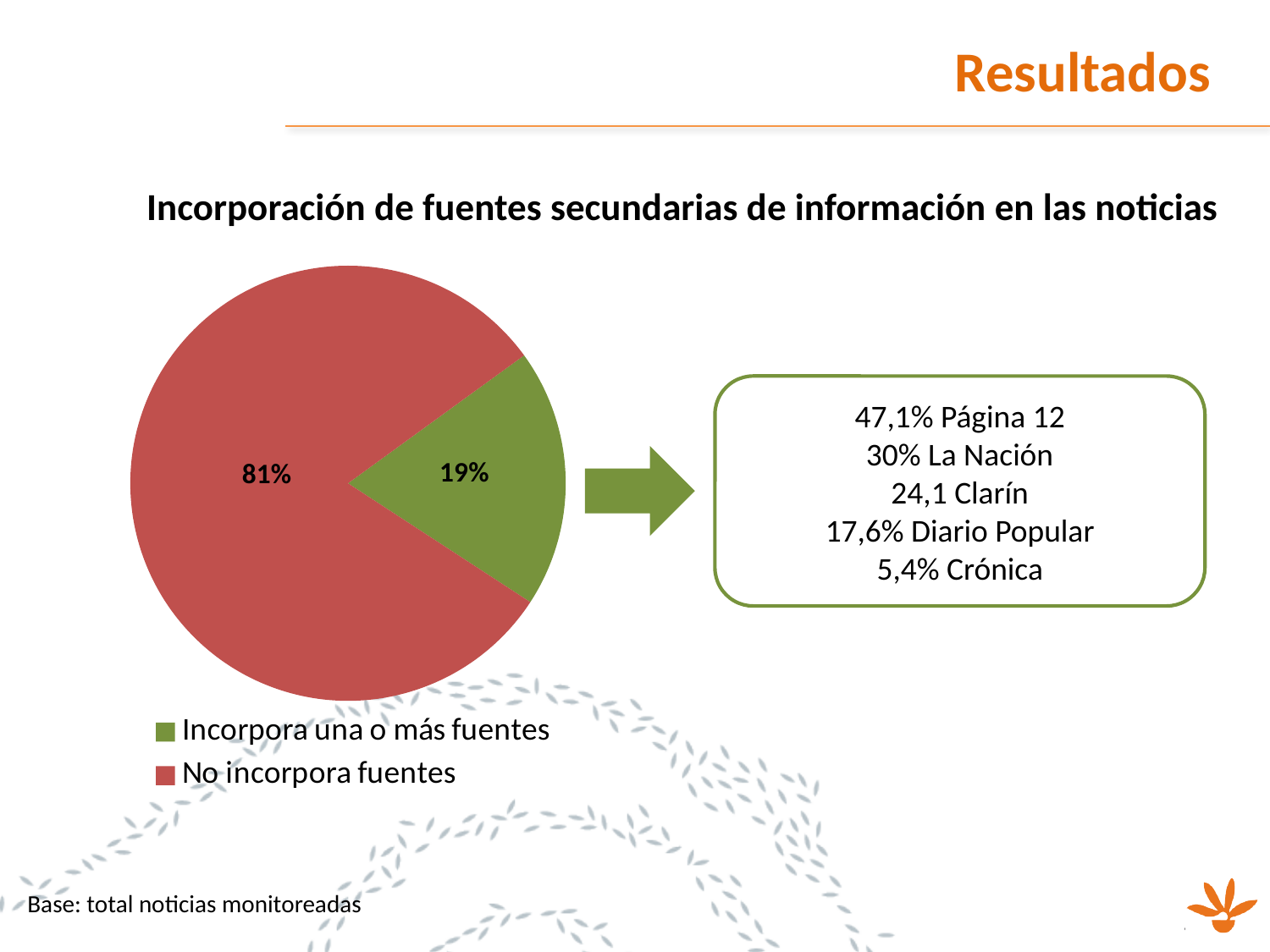
Is the share for "No incorpora fuentes" greater or less than 50%? greater What is the difference in percentage points between "No incorpora fuentes" and "Incorpora una o más fuentes"? 62% What percentage of news items incorporate one or more sources ("Incorpora una o más fuentes")? 19% What is the title of the chart? Incorporación de fuentes secundarias de información en las noticias What colour is the slice for "Incorpora una o más fuentes"? green What kind of chart is shown on the slide? pie chart What percentage of news items do not incorporate sources ("No incorpora fuentes")? 81% How many entries does the legend list? 2 Which category has the smallest share of the pie? Incorpora una o más fuentes How many slices does the pie chart have? 2 Which is larger: the share for "Incorpora una o más fuentes" or the share for "No incorpora fuentes"? No incorpora fuentes Which category has the largest share of the pie? No incorpora fuentes